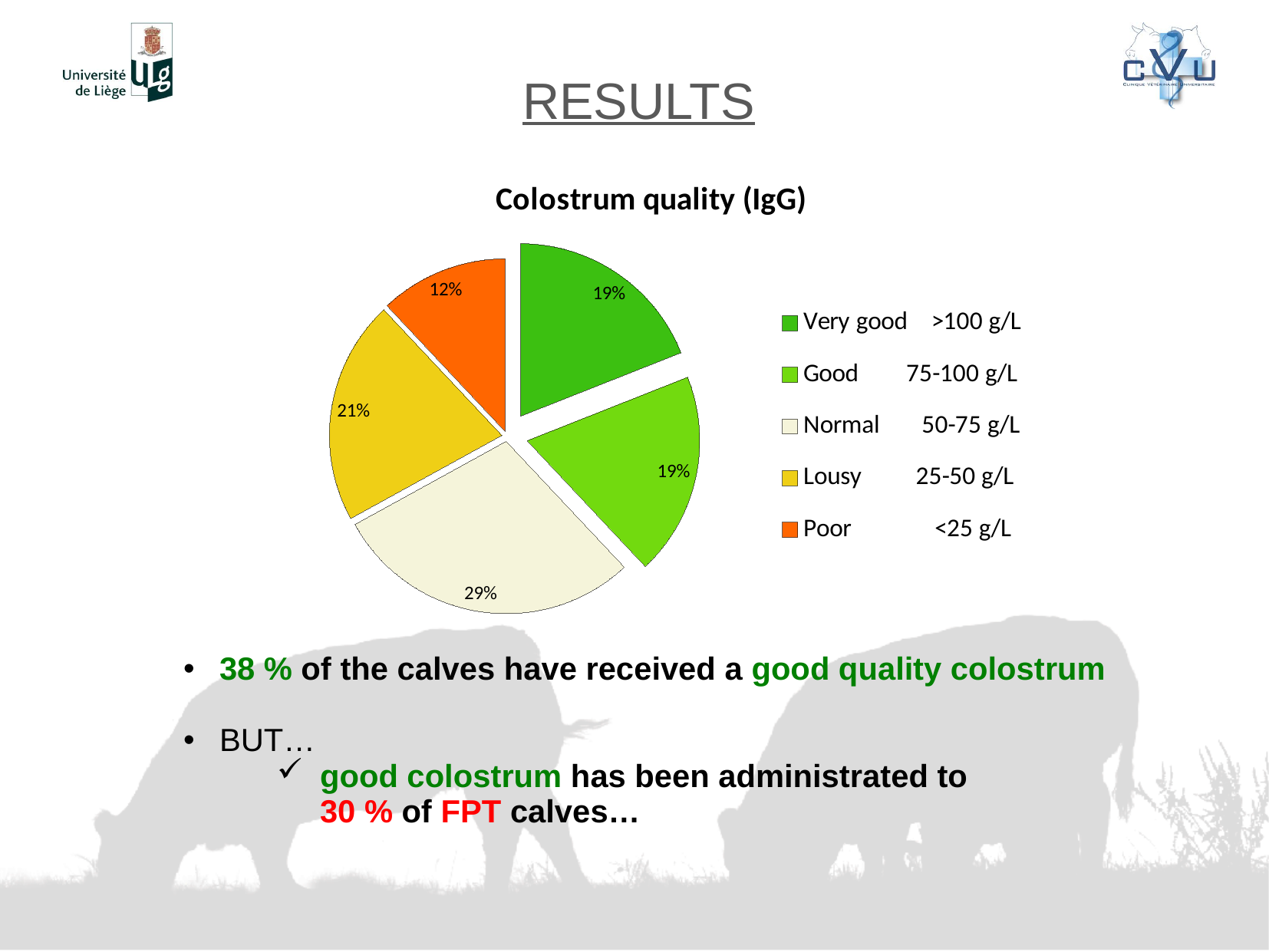
What IgG range does the legend give for the Good category? 75-100 g/L Which category has the largest slice of the pie? Normal What share of the pie is the Normal category? 29% What share of the pie is the Lousy category? 21% What is the difference in percentage points between the Normal and Poor slices? 17 What share of the pie is the Very good category? 19% What kind of chart is shown on the slide? pie chart Which category has the smallest slice of the pie? Poor How many categories does the pie chart have? 5 What is the title of the chart? Colostrum quality (IgG) Which slice is larger, Lousy or Poor? Lousy